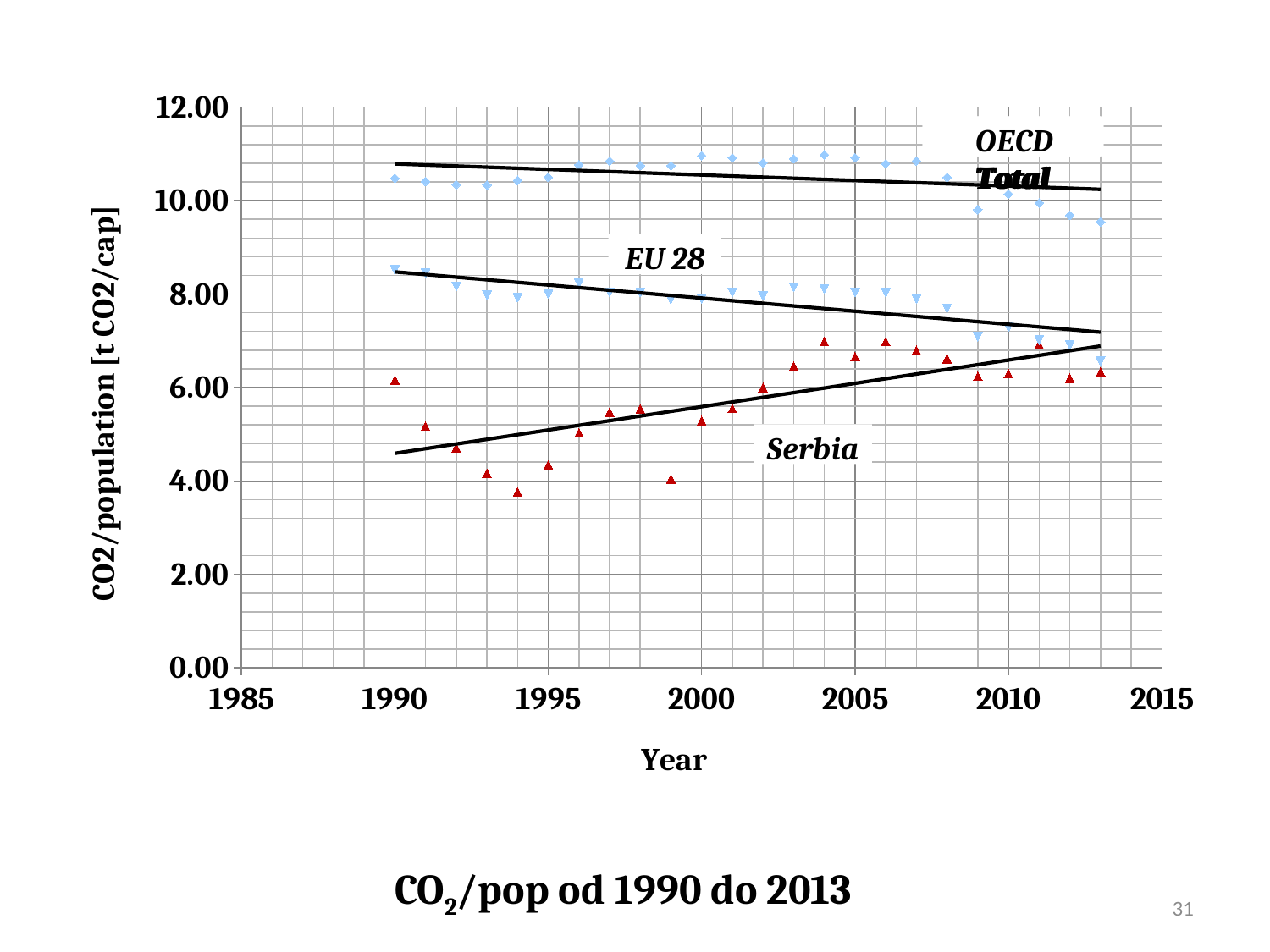
What kind of chart is shown on the slide? scatter chart Is the value for Serbia in 2004 greater or less than 6.00? greater Which series has the highest values throughout the chart? OECD Total Which series has the lowest values in 1990? Serbia Is the value for OECD Total in 2004 greater or less than 10.00? greater How many data series are plotted on the chart? 3 In 2000, which is larger: the value for OECD Total or the value for Serbia? OECD Total Does the Serbia trend line rise or fall from 1990 to 2013? rise Is the value for Serbia in 1994 greater or less than 4.00? less Does the EU 28 trend line rise or fall from 1990 to 2013? fall What is the label of the vertical axis? CO2/population [t CO2/cap]